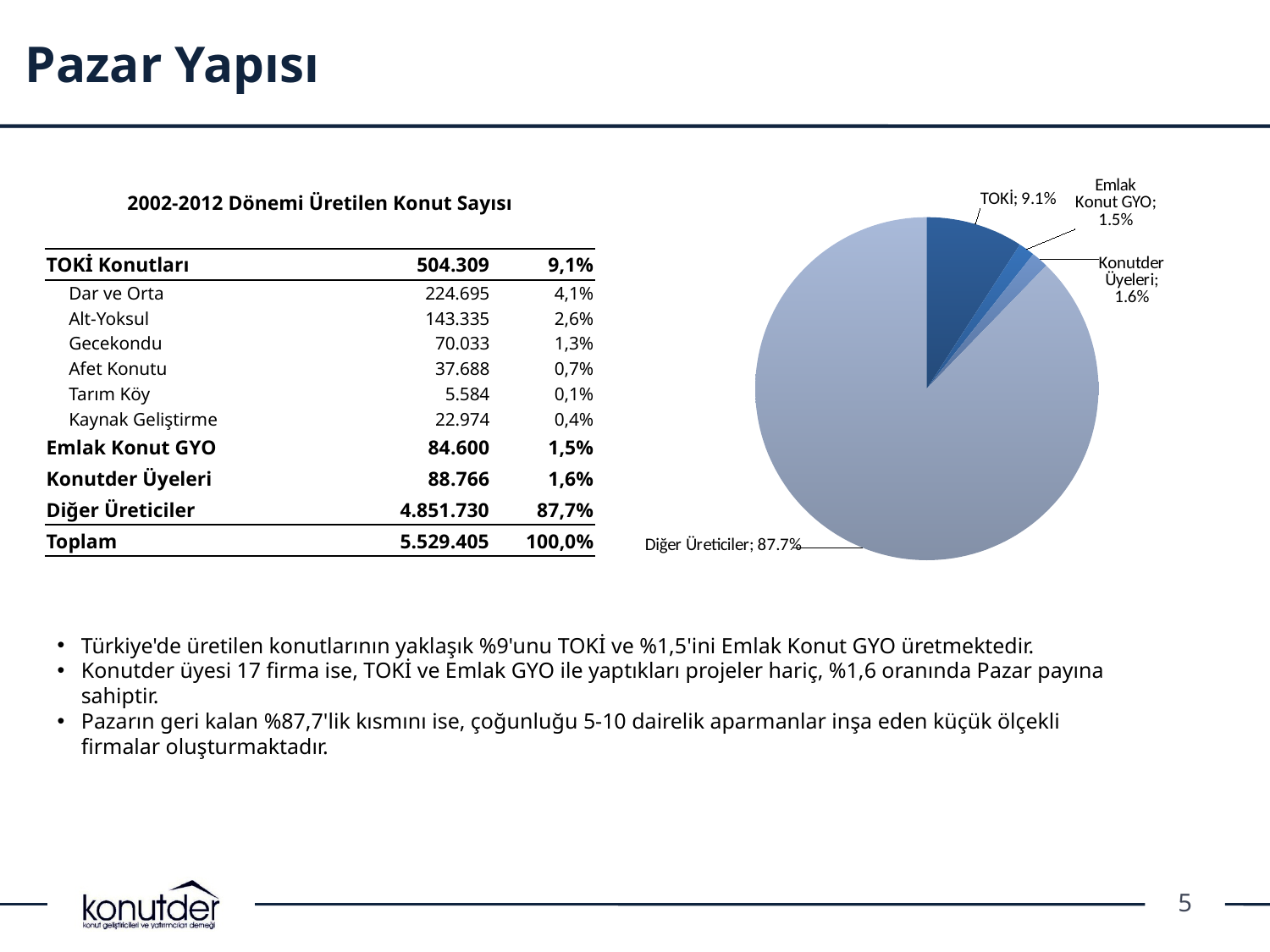
Which slice of the pie chart is drawn in the darkest blue? TOKİ How many slices does the pie chart have? 4 What share of the pie does Diğer Üreticiler hold? 87.7% What is the difference in percentage points between the Diğer Üreticiler slice and the TOKİ slice? 78.6 Which slice of the pie chart is the largest? Diğer Üreticiler What kind of chart is shown on the slide? pie chart What share of the pie does Emlak Konut GYO hold? 1.5% What share of the pie does Konutder Üyeleri hold? 1.6% What is the difference in percentage points between the TOKİ slice and the Emlak Konut GYO slice? 7.6 Which slice of the pie chart is the smallest? Emlak Konut GYO Which is larger in the pie chart, TOKİ or Konutder Üyeleri? TOKİ